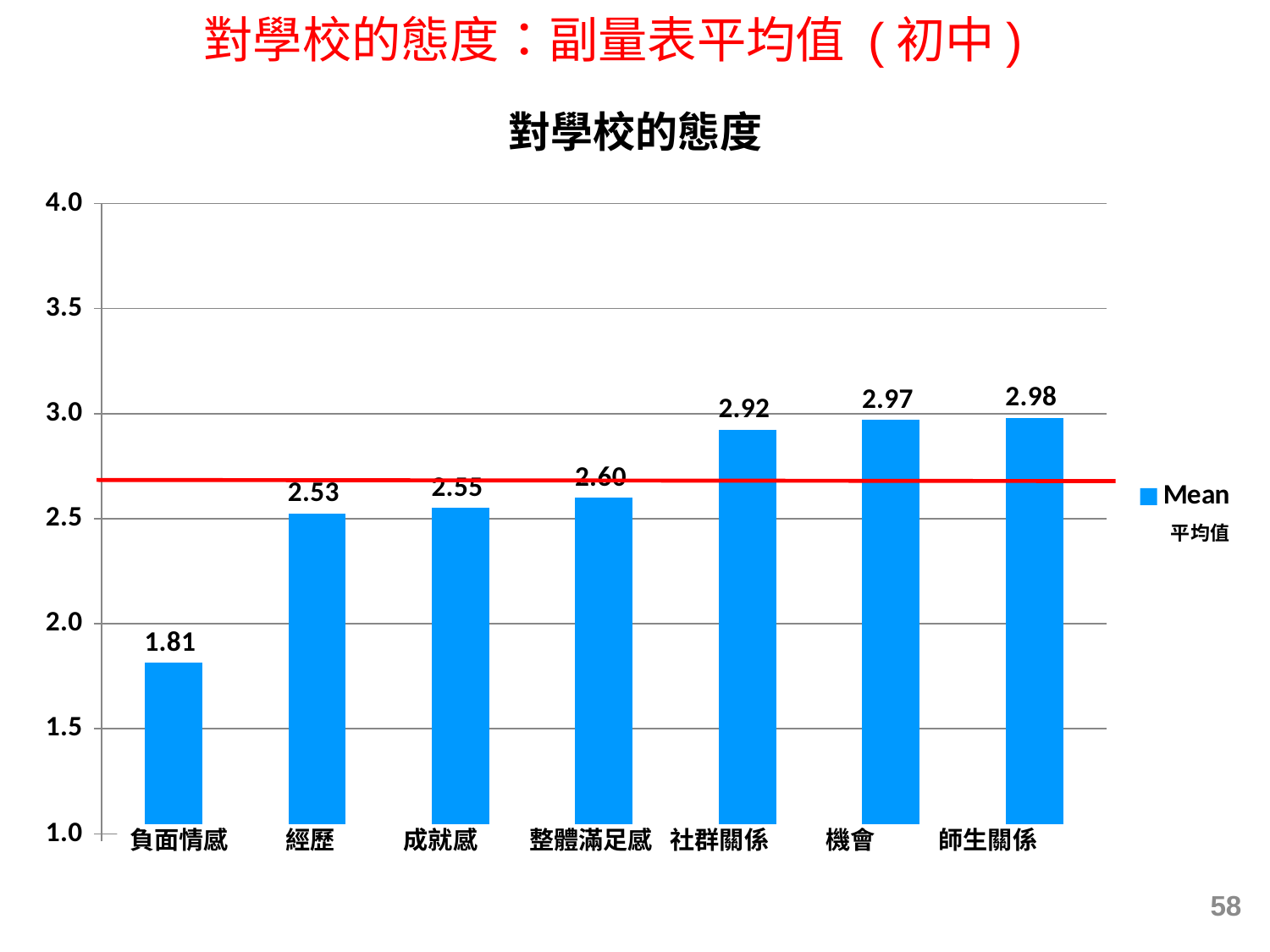
Which category has the highest value? 師生關係 Which category has the lowest value? 負面情感 How many series does the legend list? 1 What kind of chart is this? bar chart What is the value for 負面情感? 1.81 What is the value for 機會? 2.97 What is the value for 整體滿足感? 2.60 Is the value for 負面情感 greater or less than 2.0? less How many categories are shown on the x axis? 7 What is the difference between the values for 社群關係 and 經歷? 0.39 Which is larger, the value for 成就感 or the value for 社群關係? 社群關係 What is the title of the chart? 對學校的態度